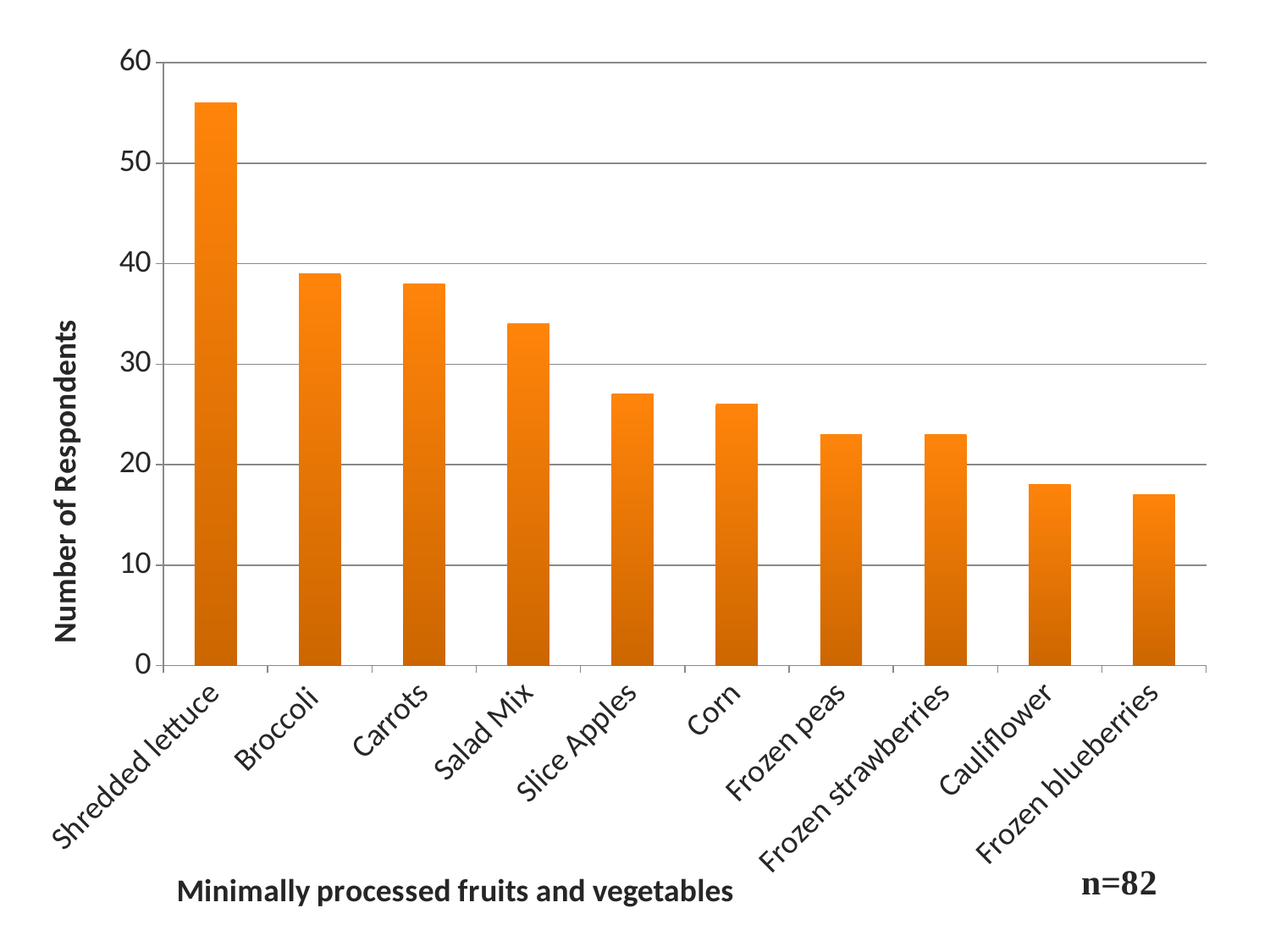
Is the value for Salad Mix greater or less than 30? greater Is the value for Shredded lettuce greater or less than 50? greater Which category has the highest number of respondents? Shredded lettuce Do the values generally rise or fall moving from left to right along the x axis? fall Is the value for Cauliflower greater or less than 20? less What kind of chart is shown on the slide? bar chart What is the title of the vertical axis? Number of Respondents Which has more respondents, Shredded lettuce or Broccoli? Shredded lettuce Which has more respondents, Salad Mix or Corn? Salad Mix How many categories of minimally processed fruits and vegetables are shown on the x axis? 10